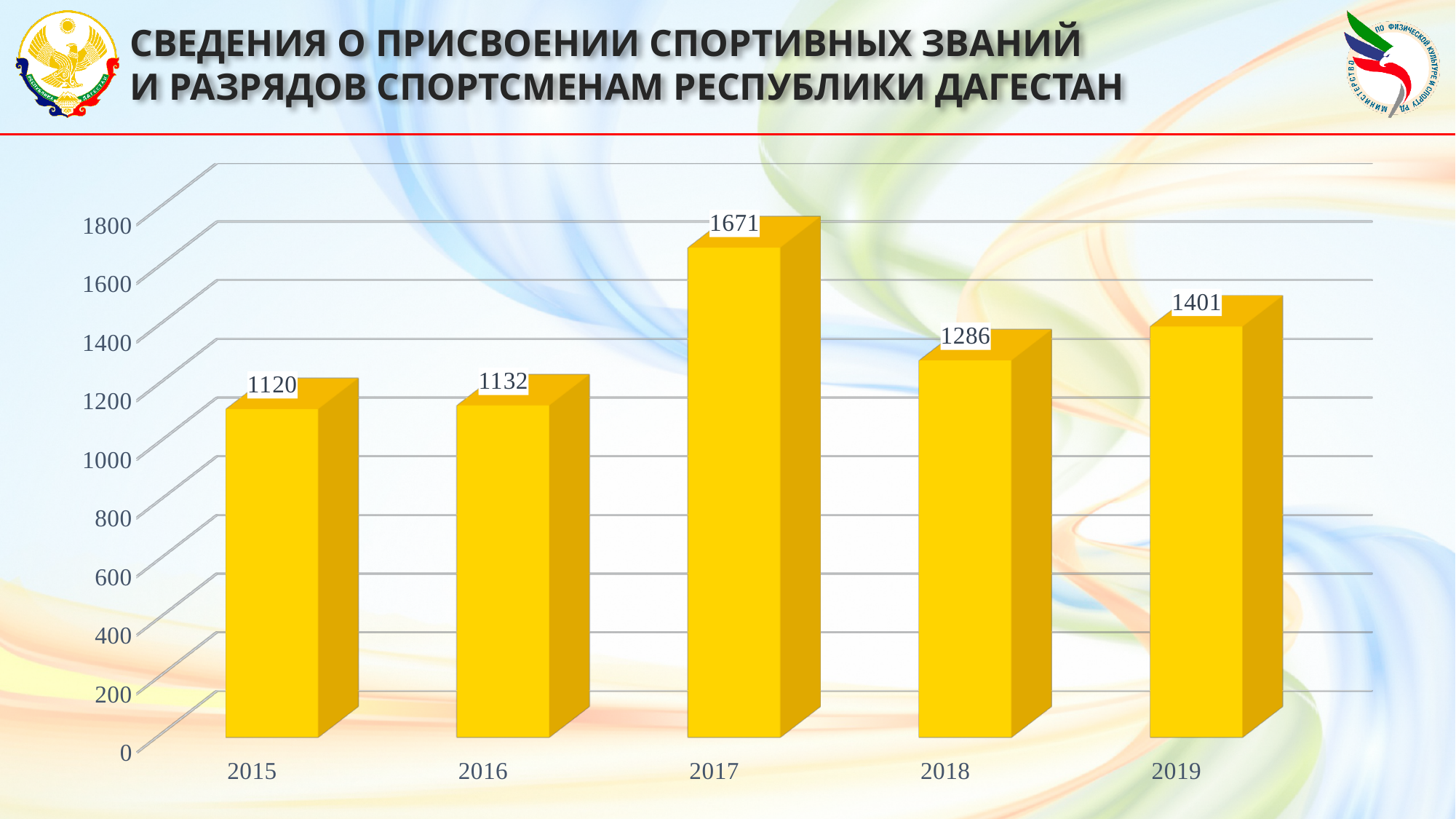
What is the difference between the values for 2019 and 2015? 281 Which is larger, the value for 2018 or the value for 2019? 2019 What is the value for 2015? 1120 Which year has the lowest value? 2015 Which year has the highest value? 2017 What is the value for 2019? 1401 What is the difference between the values for 2017 and 2018? 385 How many years are shown on the chart? 5 What kind of chart is shown on the slide? bar chart Is the value for 2016 greater or less than 1000? greater Does the value rise or fall from 2017 to 2018? fall What is the value for 2017? 1671